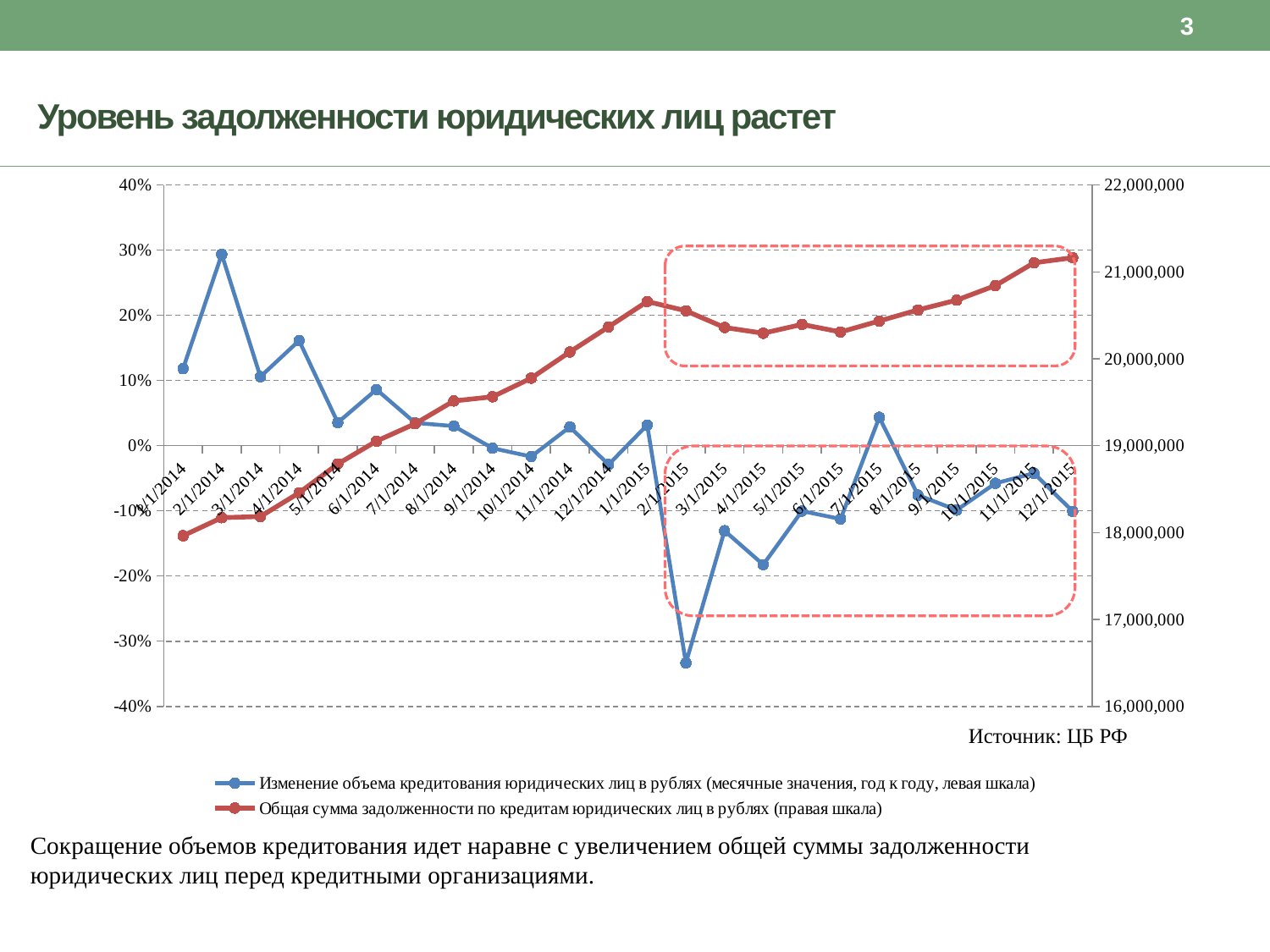
How many monthly points are plotted along the x axis? 24 How many series does the legend list? 2 At which date is the series 'Общая сумма задолженности по кредитам юридических лиц в рублях' lowest? 1/1/2014 Is the value of the 'Общая сумма задолженности' series at 12/1/2015 greater or less than 21,000,000? greater Is the value of the 'Изменение объема кредитования' series at 2/1/2014 greater or less than 20%? greater Does the 'Общая сумма задолженности по кредитам юридических лиц в рублях' series generally rise or fall from 1/1/2014 to 12/1/2015? Rise What source is cited below the chart? ЦБ РФ At which date does the series 'Изменение объема кредитования юридических лиц в рублях' reach its highest value? 2/1/2014 At which date does the series 'Изменение объема кредитования юридических лиц в рублях' reach its lowest value? 2/1/2015 At which date is the series 'Общая сумма задолженности по кредитам юридических лиц в рублях' highest? 12/1/2015 Is the value of the 'Изменение объема кредитования' series at 2/1/2015 greater or less than -30%? less What kind of chart is shown on the slide? Line chart